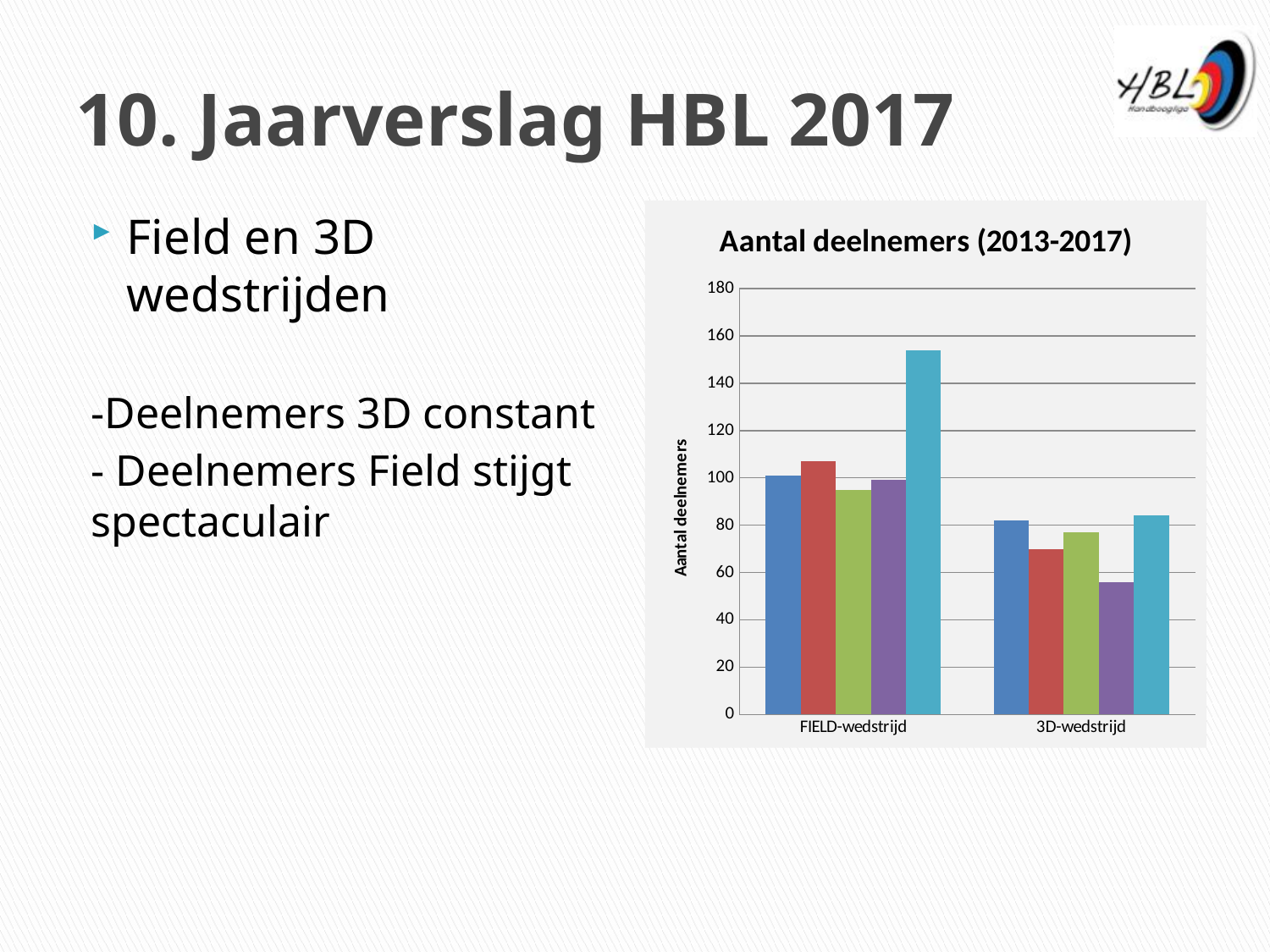
How many categories are shown on the x axis of the chart? 2 What type of chart is shown on the slide? bar chart How many bars are plotted for the FIELD-wedstrijd category? 5 Is the value of the first (blue) bar for FIELD-wedstrijd greater or less than 80? greater Is the value of the shortest bar for 3D-wedstrijd greater or less than 80? less What is the label on the vertical axis of the chart? Aantal deelnemers Is the value of the second (red) bar for 3D-wedstrijd greater or less than 80? less What is the title of the chart? Aantal deelnemers (2013-2017) Which is larger: the tallest bar for FIELD-wedstrijd or the tallest bar for 3D-wedstrijd? FIELD-wedstrijd Which category contains the tallest bar in the chart? FIELD-wedstrijd Which category contains the shortest bar in the chart? 3D-wedstrijd